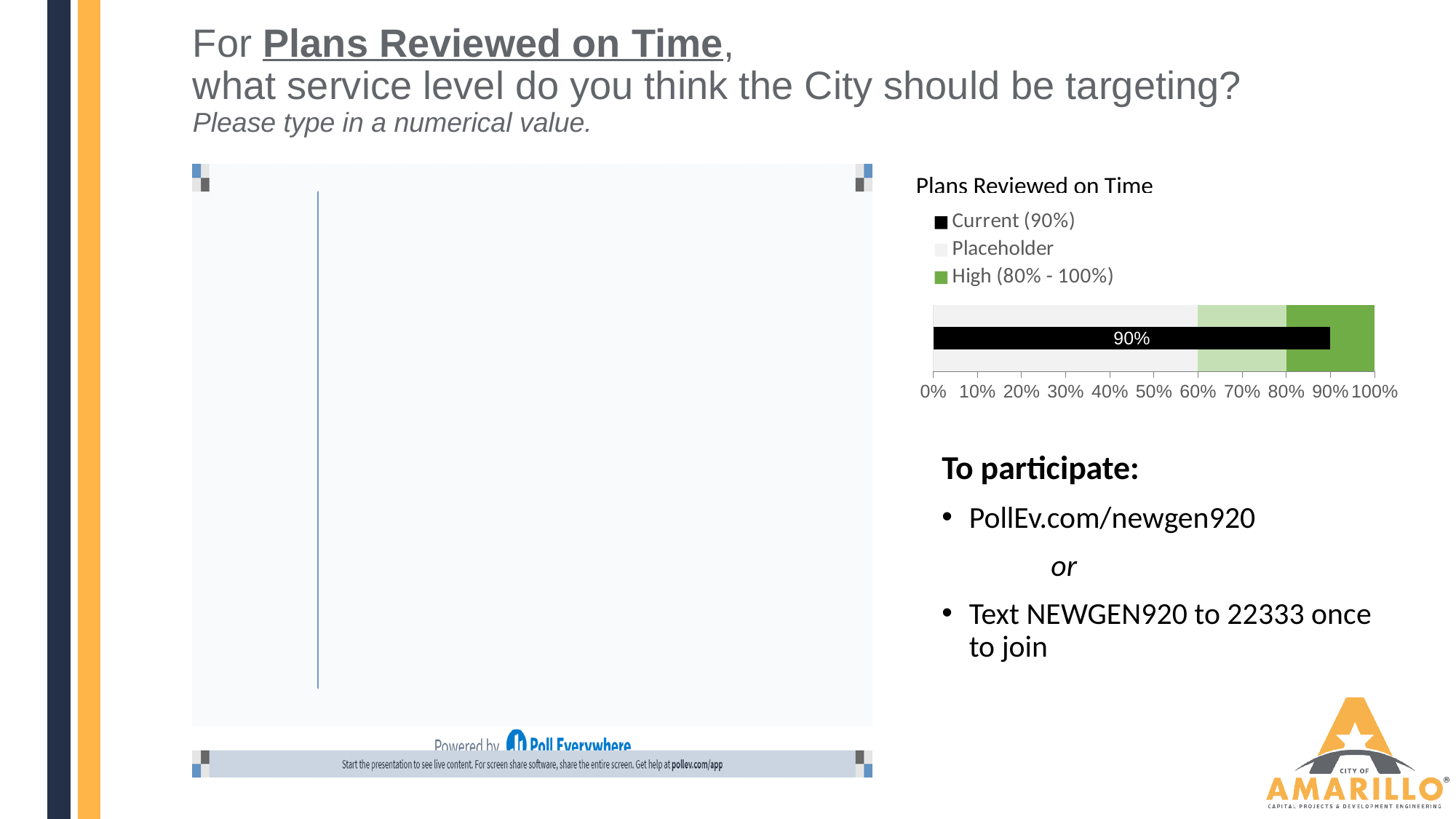
What is the first legend entry in the "Plans Reviewed on Time" chart? Current (90%) What value is labelled on the black bar in the "Plans Reviewed on Time" chart? 90% How many entries does the legend of the "Plans Reviewed on Time" chart list? 3 What is the lowest tick label on the x axis of the "Plans Reviewed on Time" chart? 0% Is the Current value in the "Plans Reviewed on Time" chart greater or less than 100%? less What kind of chart is shown under the title "Plans Reviewed on Time"? bar chart What range does the "High" legend entry give in the "Plans Reviewed on Time" chart? 80% - 100% What is the title of the chart on the slide? Plans Reviewed on Time What is the highest tick label on the x axis of the "Plans Reviewed on Time" chart? 100% Is the Current value in the "Plans Reviewed on Time" chart greater or less than 50%? greater What colour is the Current bar in the "Plans Reviewed on Time" chart? black